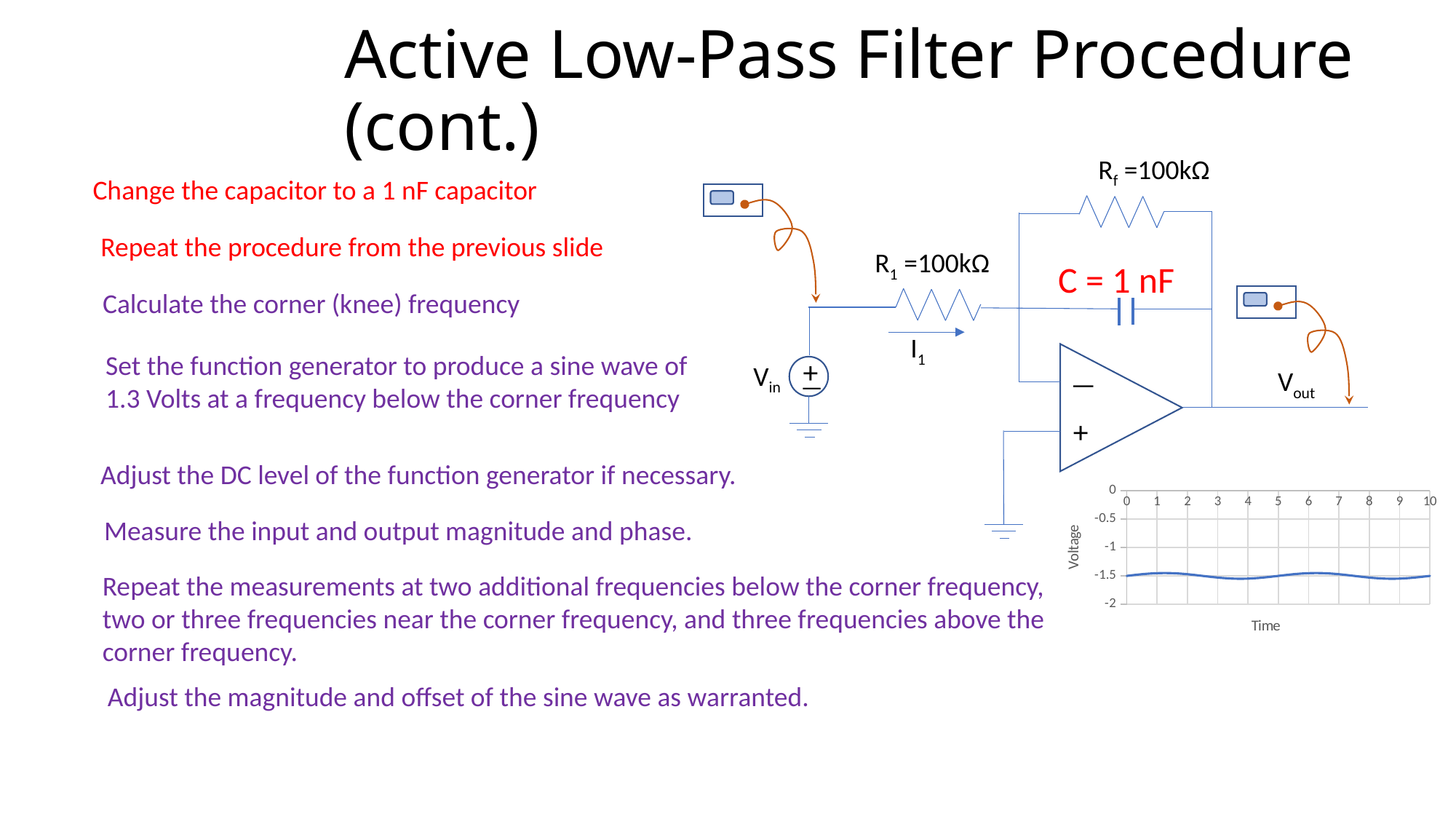
What is the label of the horizontal axis of the chart at the bottom right? Time In the chart at the bottom right, is the voltage at time 2 greater or less than -2? greater In the chart at the bottom right, does the voltage rise strongly, fall strongly, or stay roughly flat as time goes from 0 to 10? stays roughly flat What kind of chart is shown at the bottom right of the slide? line chart What is the label of the vertical axis of the chart at the bottom right? Voltage In the chart at the bottom right, is the voltage at time 5 greater or less than -1? less In the chart at the bottom right, is the voltage at time 8 greater or less than -0.5? less